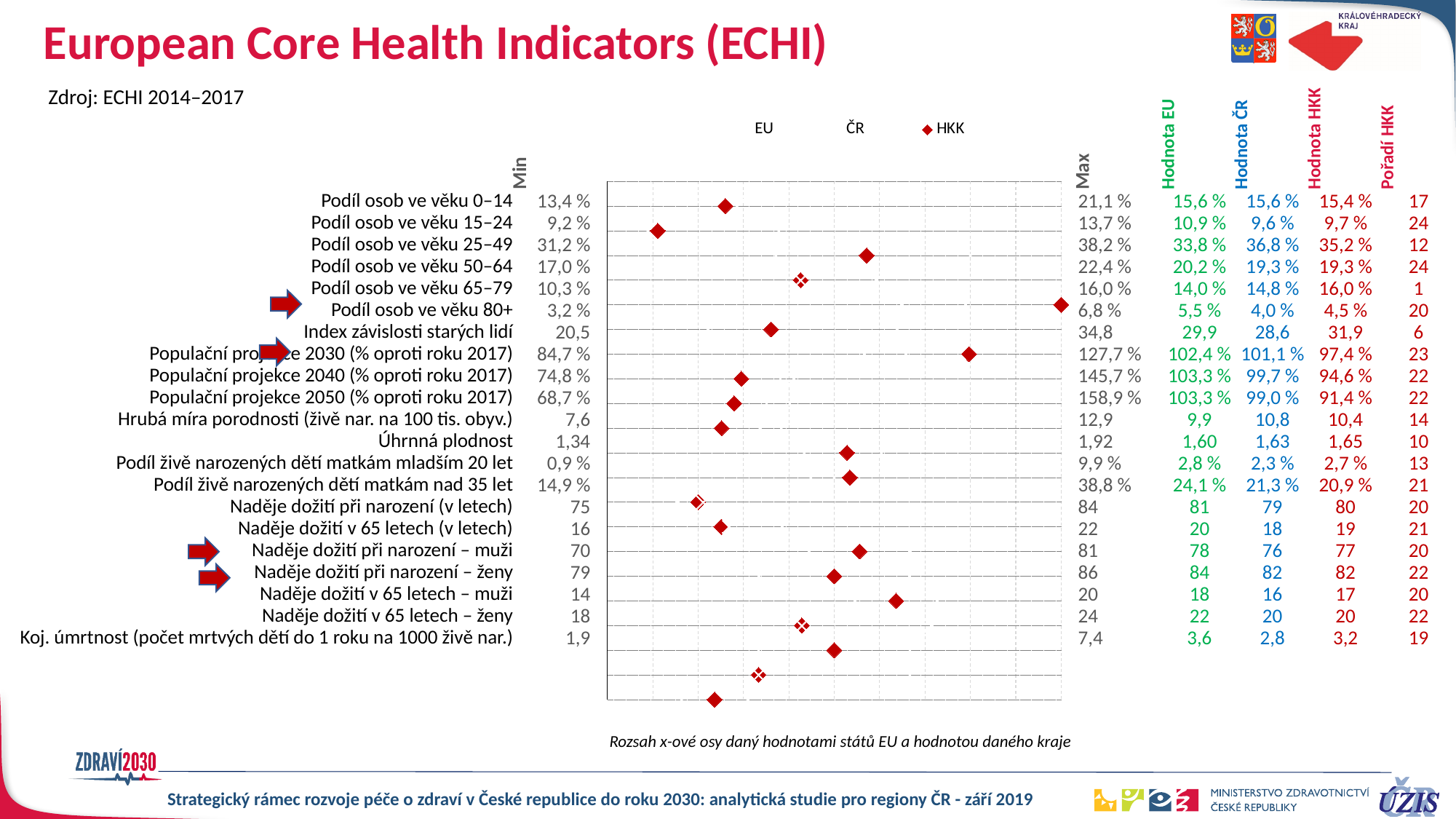
What is the Min value shown for Úhrnná plodnost? 1,34 What is the Hodnota ČR value for Index závislosti starých lidí? 28,6 What is the Hodnota EU value for Koj. úmrtnost (počet mrtvých dětí do 1 roku na 1000 živě nar.)? 3,6 What is the Pořadí HKK for Podíl osob ve věku 65–79? 1 For Podíl osob ve věku 25–49, which is larger: Hodnota ČR or Hodnota HKK? Hodnota ČR What kind of chart is shown on the slide? Scatter (dot) chart What is the difference between the Hodnota EU and Hodnota HKK values for Naděje dožití při narození (v letech)? 1 Which indicator has the lowest (best) Pořadí HKK? Podíl osob ve věku 65–79 What is the Max value shown for Populační projekce 2050 (% oproti roku 2017)? 158,9 % What is the Hodnota HKK value for Podíl osob ve věku 0–14? 15,4 % How many series does the chart legend list? 3 What is the Hodnota HKK value for Naděje dožití při narození – ženy? 82